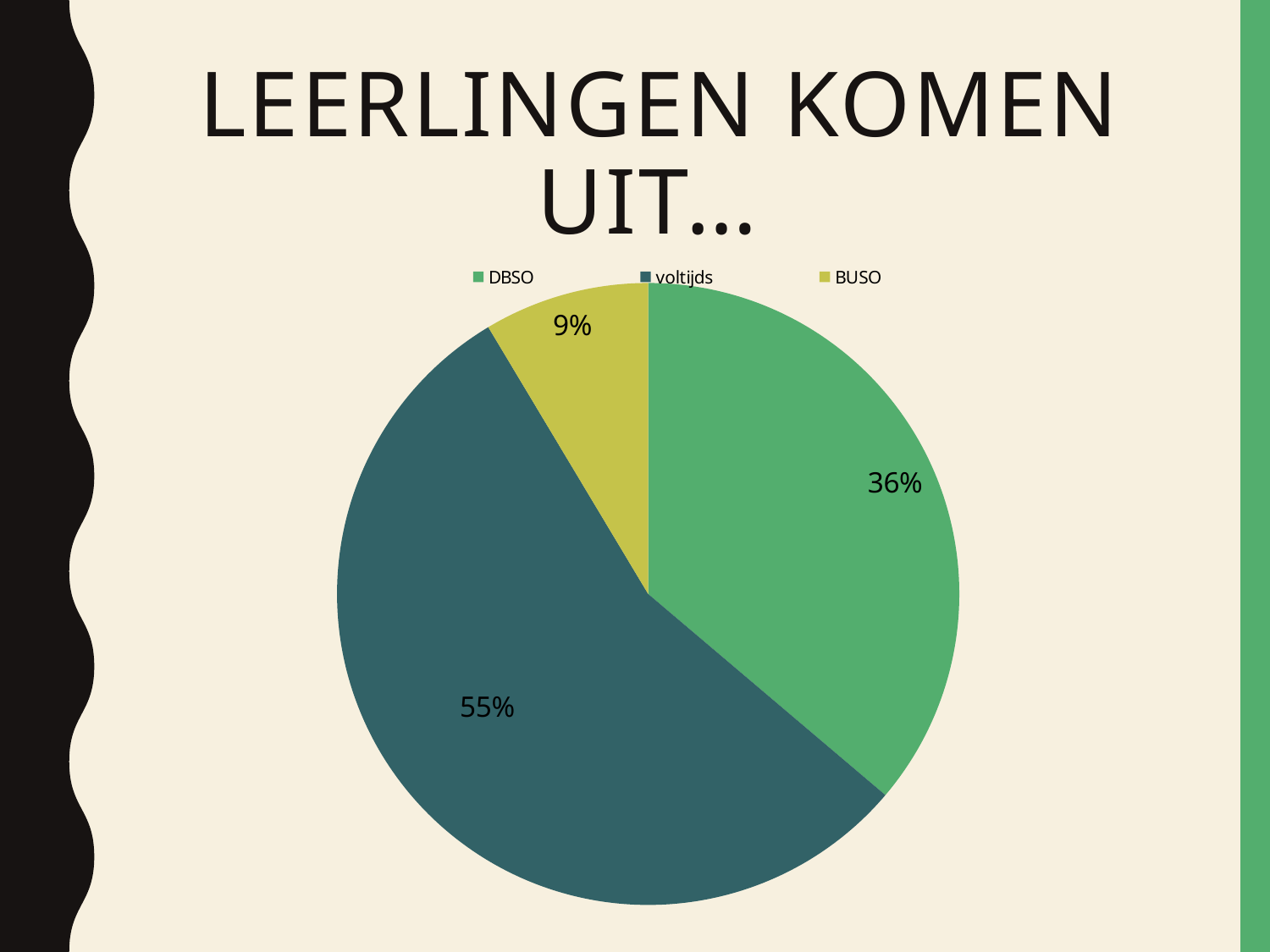
Which legend entry is shown in the dark teal colour? voltijds Which is larger, the DBSO slice or the BUSO slice? DBSO Which category has the smallest slice of the pie? BUSO How many categories are shown in the pie chart? 3 What kind of chart is shown on the slide? pie chart What share of the pie does DBSO represent? 36% What is the difference in percentage points between the DBSO slice and the BUSO slice? 27 What is the title of the slide containing the chart? LEERLINGEN KOMEN UIT... What is the difference in percentage points between the voltijds slice and the DBSO slice? 19 Which category has the largest slice of the pie? voltijds What share of the pie does voltijds represent? 55% What share of the pie does BUSO represent? 9%